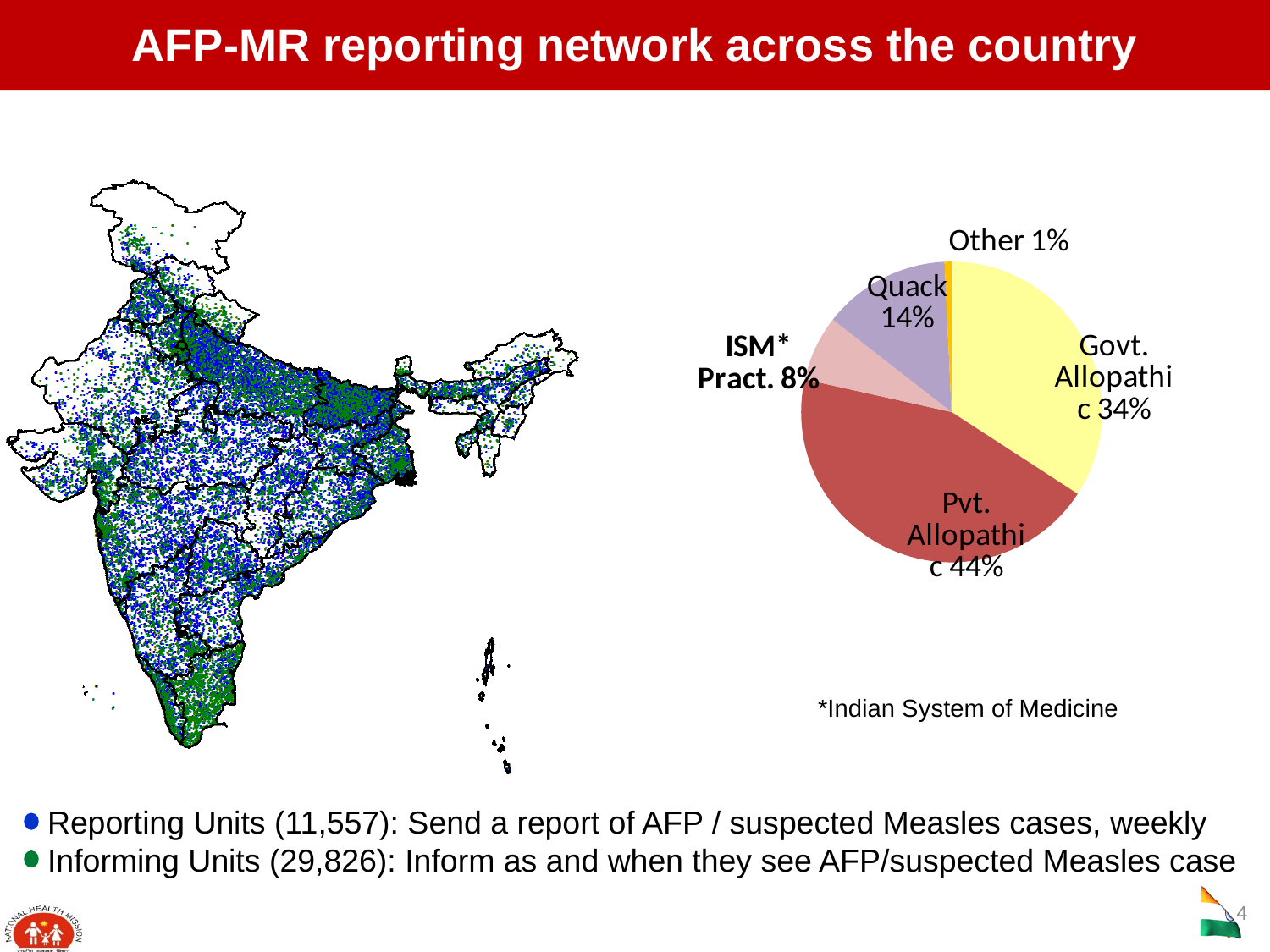
In the pie chart, what share is labelled for Other? 1% In the pie chart, what share is labelled for Quack? 14% How many slices does the pie chart have? 5 In the pie chart, what share is labelled for Pvt. Allopathic? 44% Which slice of the pie chart is the largest? Pvt. Allopathic In the pie chart, what share is labelled for Govt. Allopathic? 34% According to the footnote on the slide, what does ISM stand for? Indian System of Medicine Which slice of the pie chart is the smallest? Other What type of chart is shown on the right side of the slide? Pie chart In the pie chart, what is the difference between the Pvt. Allopathic and Govt. Allopathic shares? 10% In the pie chart, what share is labelled for ISM* Pract.? 8% In the pie chart, which is larger: Quack or ISM* Pract.? Quack